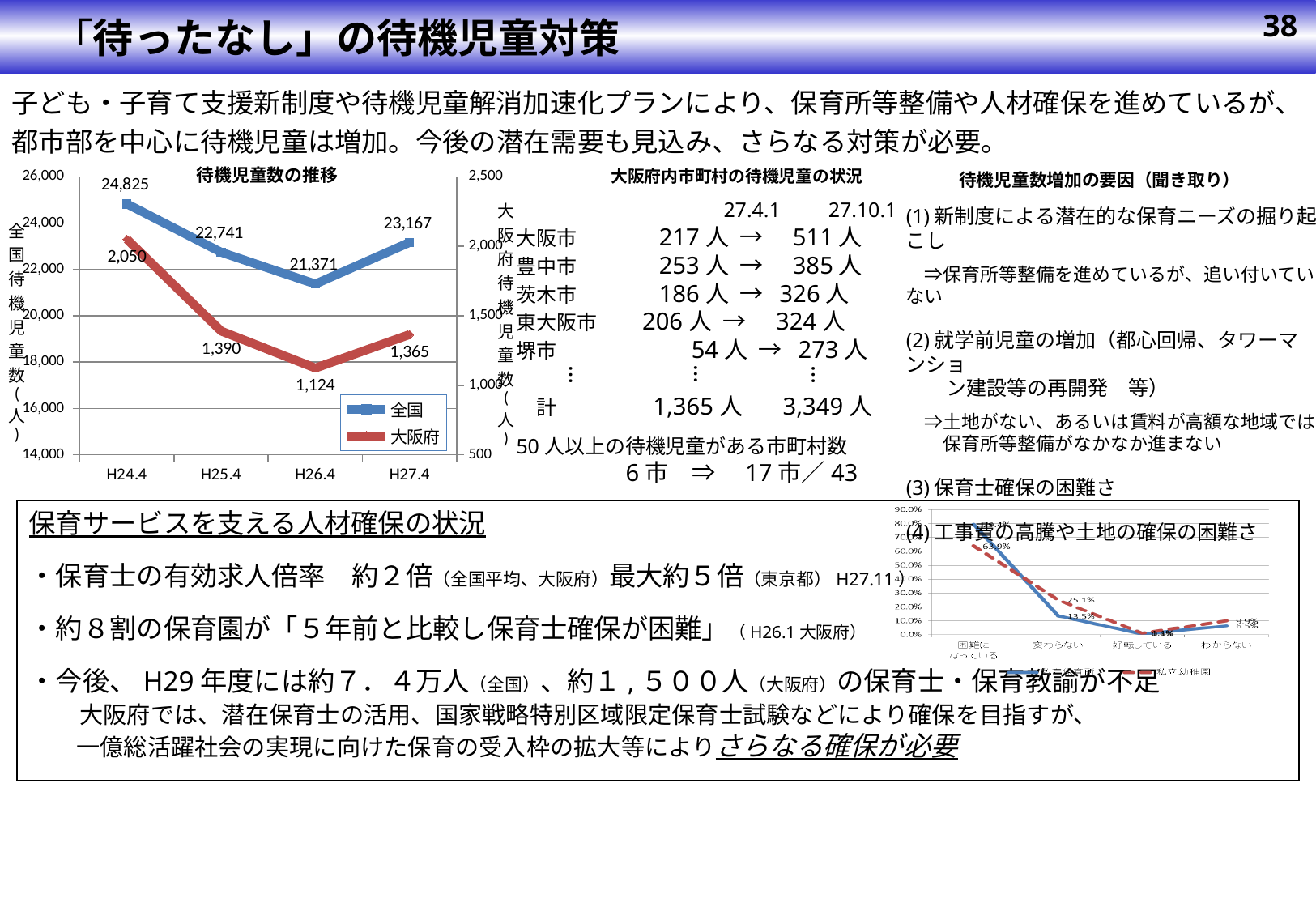
In the 待機児童数の推移 chart, what is the difference between the 大阪府 values at H25.4 and H26.4? 266 In the 待機児童数の推移 chart, what is the value for 大阪府 at H26.4? 1,124 In the 待機児童数の推移 chart, what is the value for 大阪府 at H25.4? 1,390 In the 待機児童数の推移 chart, does the 全国 series rise or fall from H24.4 to H26.4? fall In the 待機児童数の推移 chart, what is the value for 全国 at H27.4? 23,167 How many series does the legend of the 待機児童数の推移 chart list? 2 In the 待機児童数の推移 chart, what is the difference between the 全国 values at H24.4 and H27.4? 1,658 In the 待機児童数の推移 chart, at which x-axis point is the 大阪府 series highest? H24.4 In the 待機児童数の推移 chart, at which x-axis point is the 全国 series lowest? H26.4 What kind of chart is the 待機児童数の推移 chart? line chart In the 待機児童数の推移 chart, is the 大阪府 value at H27.4 larger or smaller than its value at H26.4? larger In the 待機児童数の推移 chart, what is the value for 全国 at H24.4? 24,825